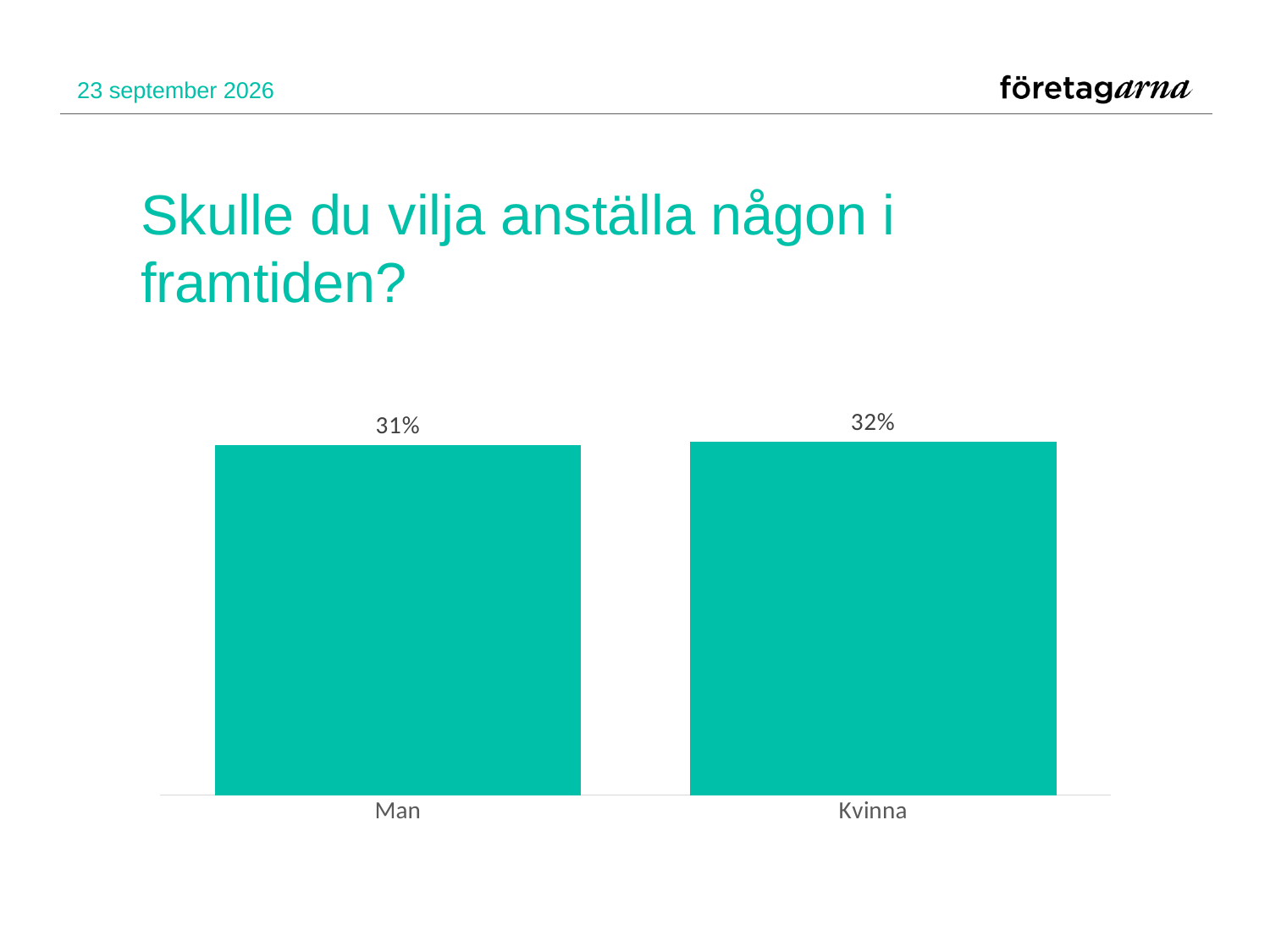
What is the value for Kvinna? 32% What is the difference between the values for Kvinna and Man? 1 percentage point What colour are the bars in the chart? Teal What kind of chart is shown on the slide? Bar chart What question does the slide title pose above the chart? Skulle du vilja anställa någon i framtiden? Which is larger, the value for Man or the value for Kvinna? Kvinna Which category has the lowest value? Man How many categories are shown in the chart? 2 What is the value for Man? 31% Which category has the highest value? Kvinna